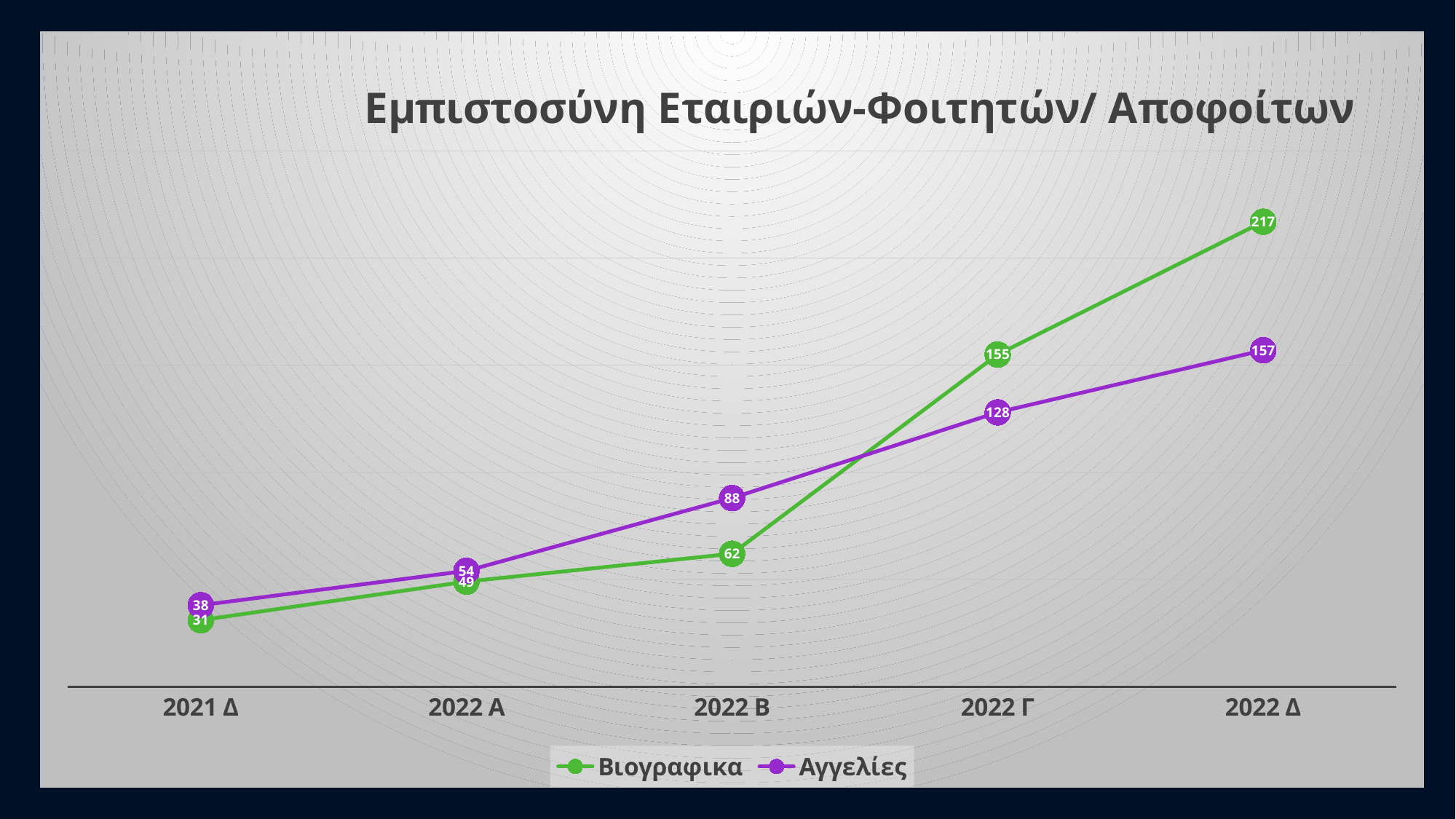
How many series does the legend list? 2 At which category does Βιογραφικα reach its highest value? 2022 Δ What kind of chart is shown on the slide? Line chart How many categories are shown on the x axis? 5 What is the difference between Βιογραφικα and Αγγελίες at 2022 Δ? 60 What is the value for Αγγελίες at 2022 Β? 88 What is the value for Βιογραφικα at 2021 Δ? 31 At which category is Αγγελίες lowest? 2021 Δ What is the value for Βιογραφικα at 2022 Δ? 217 Which series has the larger value at 2022 Β, Βιογραφικα or Αγγελίες? Αγγελίες Do the values for Βιογραφικα rise or fall from 2021 Δ to 2022 Δ? Rise What is the value for Αγγελίες at 2022 Γ? 128